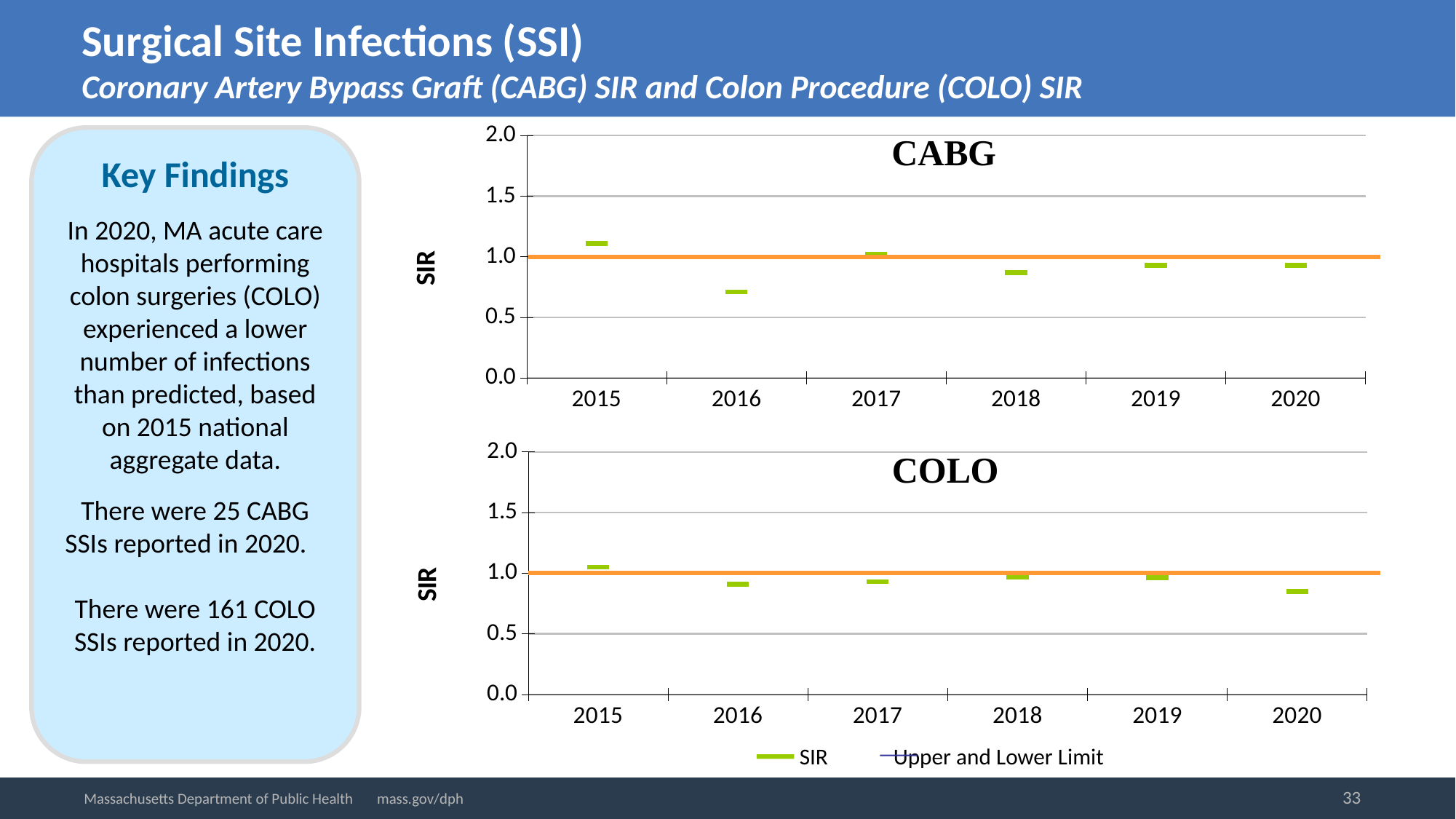
How many entries does the legend below the COLO chart list? 2 In the CABG chart, is the SIR for 2015 greater or less than 1.0? greater In the COLO chart, is the SIR for 2015 greater or less than 1.0? greater In the COLO chart, which year has the highest SIR? 2015 In the CABG chart, which year has the highest SIR? 2015 How many years are shown on the x axis of the COLO chart? 6 In the CABG chart, is the SIR for 2016 greater or less than 1.0? less In the CABG chart, which year has the lowest SIR? 2016 What is the label on the y axis of the CABG chart? SIR In the COLO chart, which year has the lowest SIR? 2020